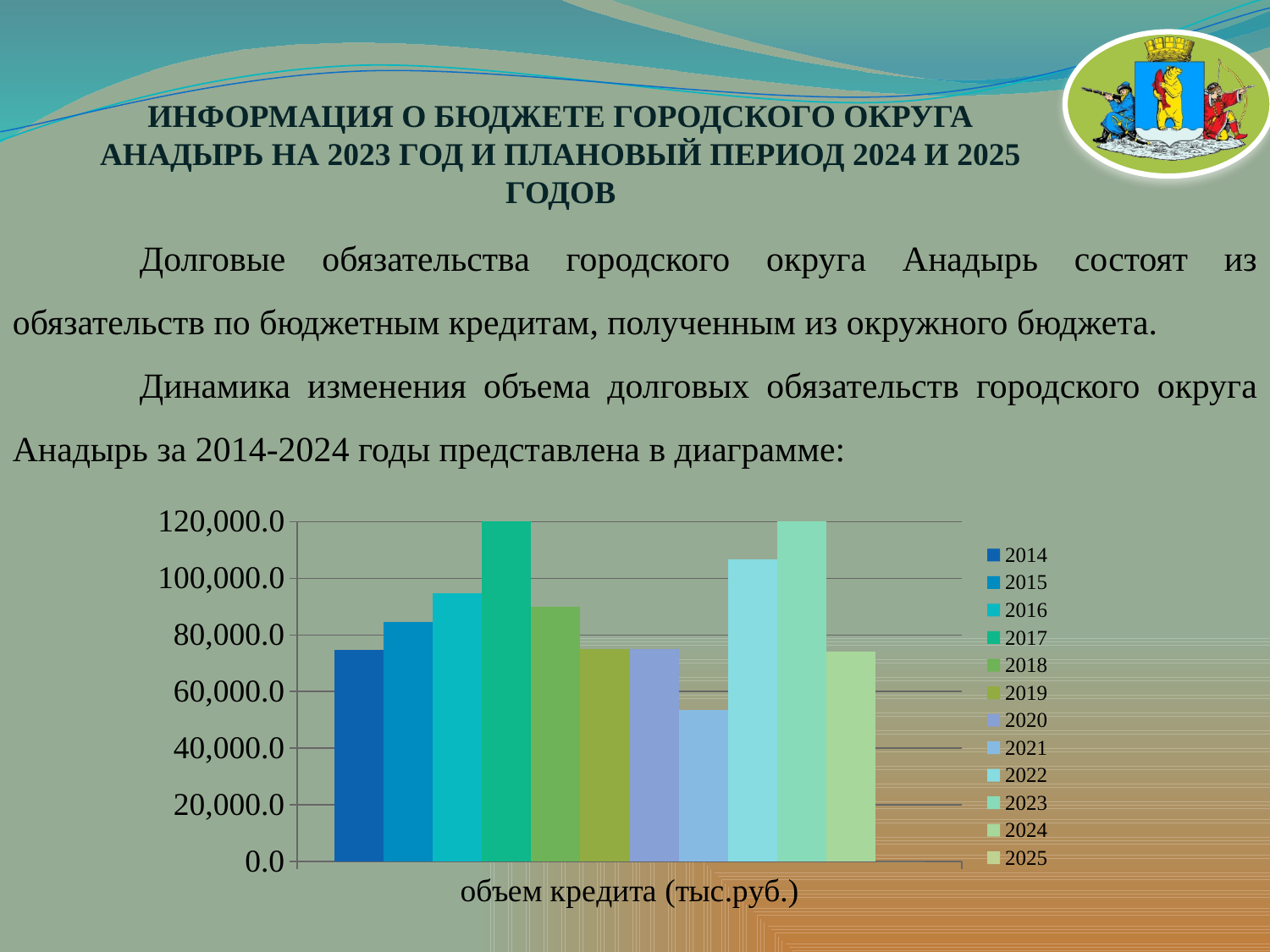
Is the value for 2022 greater or less than 100,000.0? greater How many series does the chart legend list? 12 What kind of chart is shown on the slide? bar chart Is the value for 2018 greater or less than 80,000.0? greater Which year is listed first in the chart legend? 2014 What is the label shown under the x axis of the chart? объем кредита (тыс.руб.) Which is larger, the value for 2016 or the value for 2015? 2016 Is the value for 2014 greater or less than 80,000.0? less Which is larger, the value for 2022 or the value for 2018? 2022 Which is larger, the value for 2020 or the value for 2021? 2020